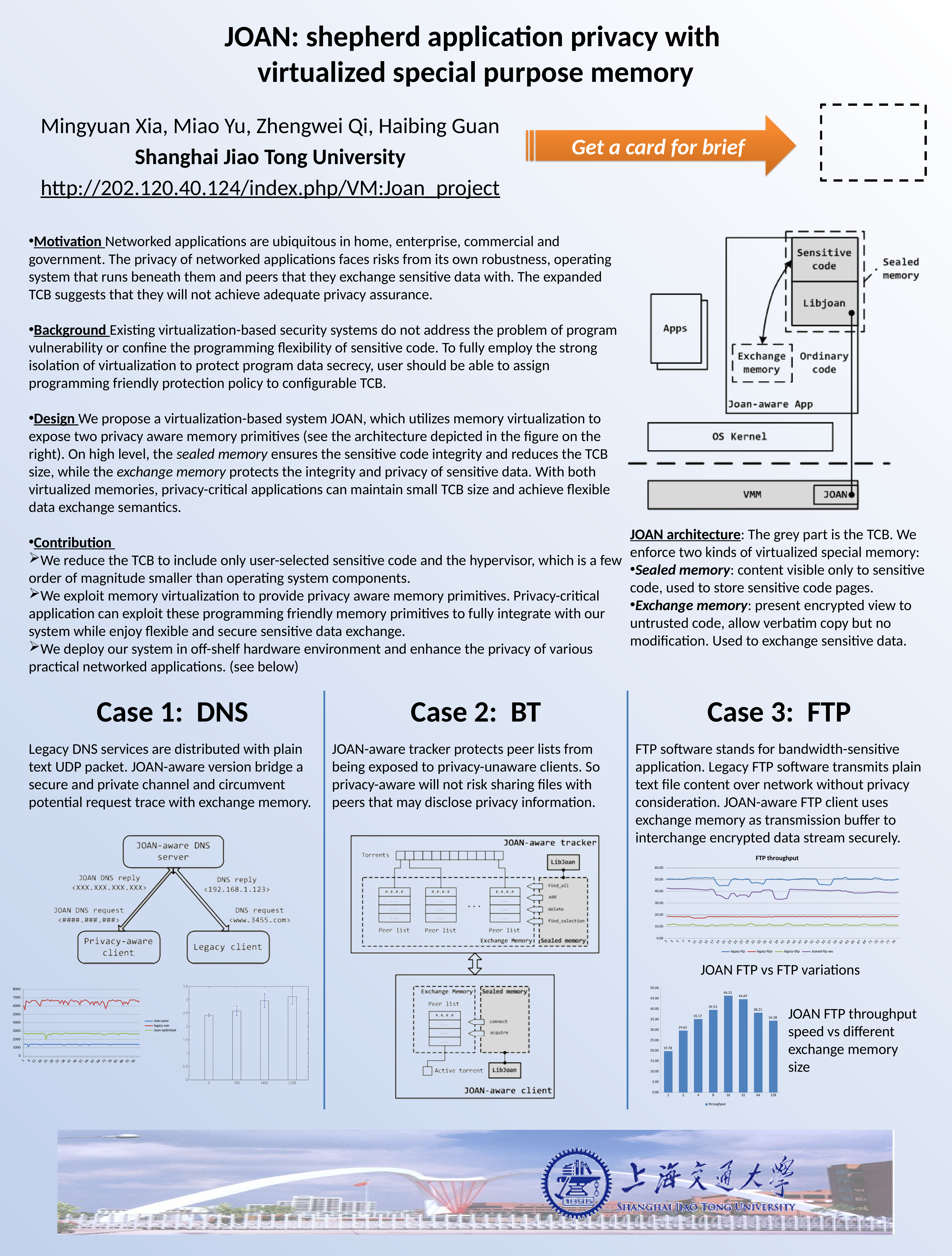
In the bar chart showing JOAN FTP throughput speed vs different exchange memory size, which exchange memory size has the lowest throughput? 1 In the 'FTP throughput' line chart, is the value for legacy-sftp greater or less than 20.00? less In the bar chart showing JOAN FTP throughput speed vs different exchange memory size, what is the throughput for exchange memory size 16? 46.31 In the bar chart showing JOAN FTP throughput speed vs different exchange memory size, what is the throughput for exchange memory size 128? 34.38 In the 'FTP throughput' line chart, is the value for legacy-ftp greater or less than 40.00? greater In the bar chart showing JOAN FTP throughput speed vs different exchange memory size, which exchange memory size has the highest throughput? 16 In the bar chart showing JOAN FTP throughput speed vs different exchange memory size, which has the larger throughput: size 32 or size 64? 32 In the bar chart showing JOAN FTP throughput speed vs different exchange memory size, what is the difference between the throughput at size 16 and at size 1? 26.53 In the bar chart showing JOAN FTP throughput speed vs different exchange memory size, what is the throughput for exchange memory size 1? 19.78 How many series does the legend of the line chart under Case 1: DNS list? 3 In the bar chart showing JOAN FTP throughput speed vs different exchange memory size, how many exchange memory sizes are plotted? 8 How many series does the legend of the 'FTP throughput' line chart list? 4